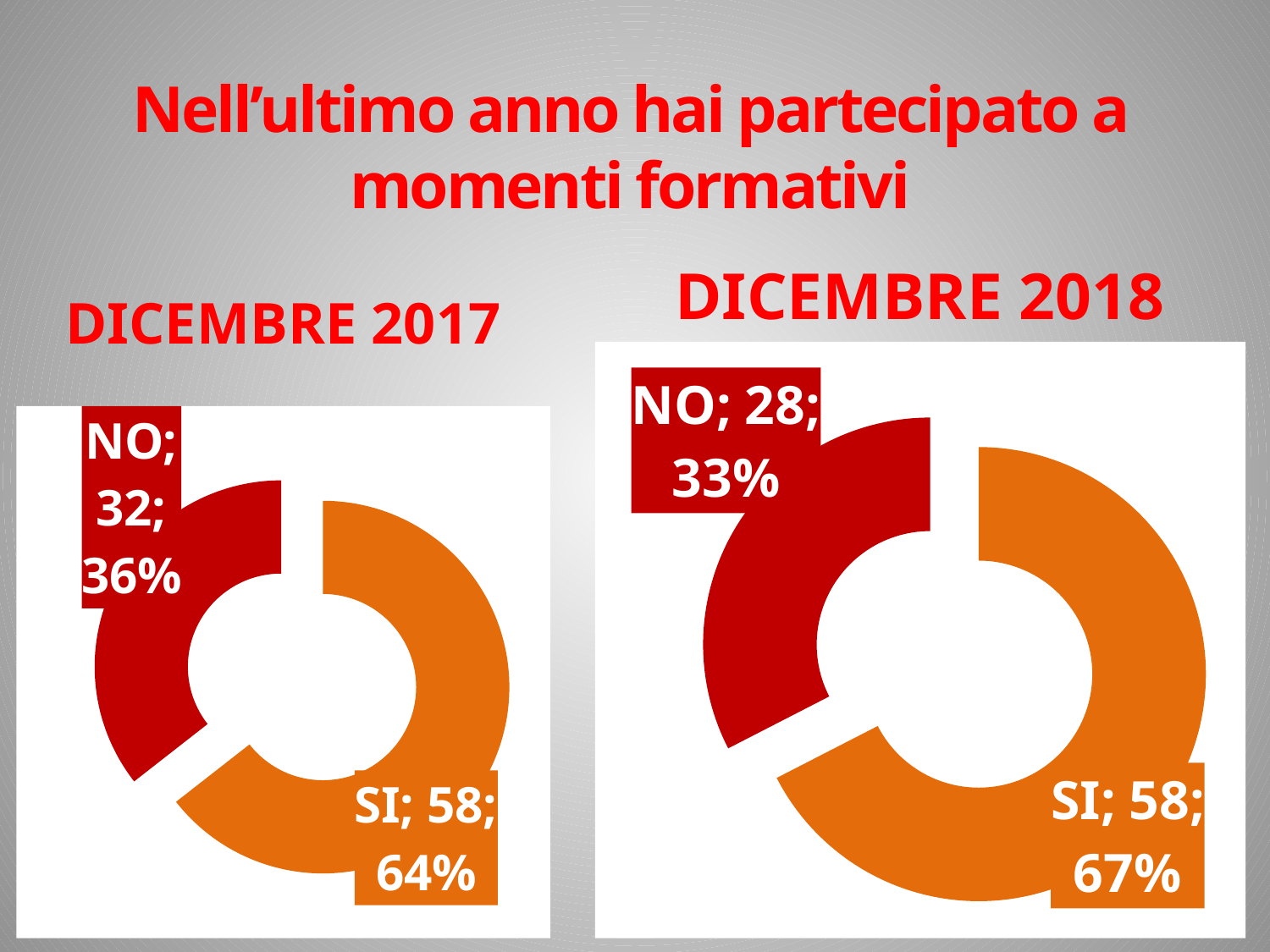
Is the NO value larger in the DICEMBRE 2017 chart or the DICEMBRE 2018 chart? DICEMBRE 2017 In the DICEMBRE 2018 chart, which category is the smallest? NO What kind of chart is the DICEMBRE 2017 chart? Doughnut chart In the DICEMBRE 2018 chart, what is the total of the SI and NO values? 86 In the DICEMBRE 2017 chart, which category is the largest? SI In the DICEMBRE 2018 chart, what percentage share does NO have? 33% How many categories does the DICEMBRE 2018 chart show? 2 In the DICEMBRE 2017 chart, what percentage share does SI have? 64% In the DICEMBRE 2018 chart, what percentage share does SI have? 67% In the DICEMBRE 2017 chart, what is the difference between the SI and NO values? 26 In the DICEMBRE 2017 chart, what is the value for NO? 32 In the DICEMBRE 2018 chart, what is the value for NO? 28